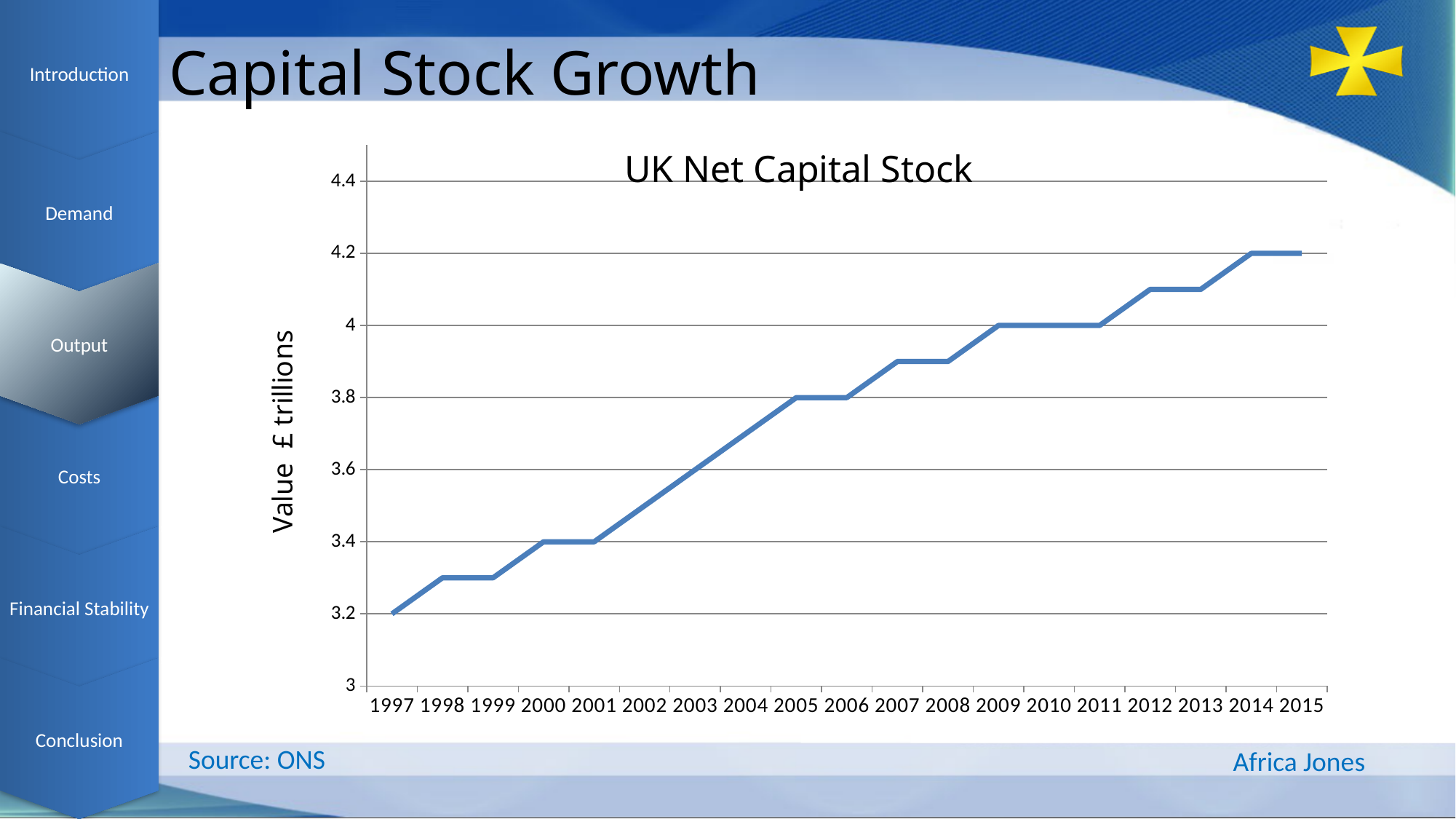
What kind of chart is shown on the slide? line chart What is the title of the chart? UK Net Capital Stock Which year has the lowest value of UK net capital stock? 1997 What is the value of UK net capital stock in 2009? 4 Is the value for 2002 greater or less than 3.4? greater What is the label on the vertical axis of the chart? Value £ trillions How many years are plotted on the x axis? 19 By how much did UK net capital stock increase between 1997 and 2015, in £ trillions? 1 What is the value of UK net capital stock in 2015? 4.2 What is the value of UK net capital stock in 1997? 3.2 Which year has the larger value, 2000 or 2005? 2005